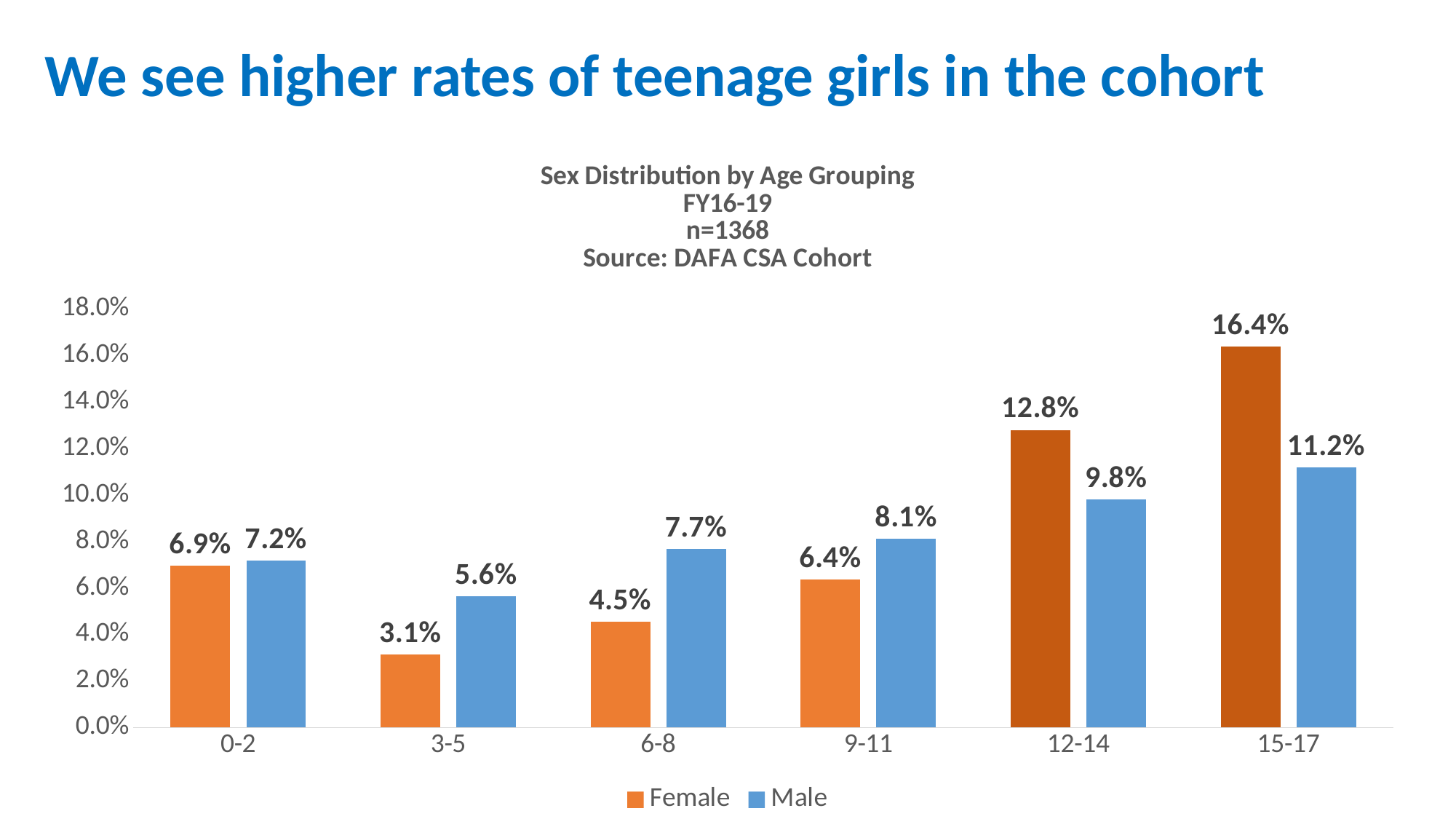
How many series does the legend list? 2 What is the Male value for the 3-5 age group? 5.6% What is the Female value for the 15-17 age group? 16.4% What is the sample size (n) stated in the chart title? 1368 What kind of chart is shown on the slide? bar chart Is the Male value for the 12-14 age group greater or less than 10.0%? less What is the difference between the Female and Male values for the 12-14 age group? 3.0% Which age group has the lowest Female value? 3-5 Which age group has the highest Male value? 15-17 How many age groups are shown on the x axis? 6 Which is larger for the 6-8 age group, the Female value or the Male value? Male What is the Female value for the 9-11 age group? 6.4%